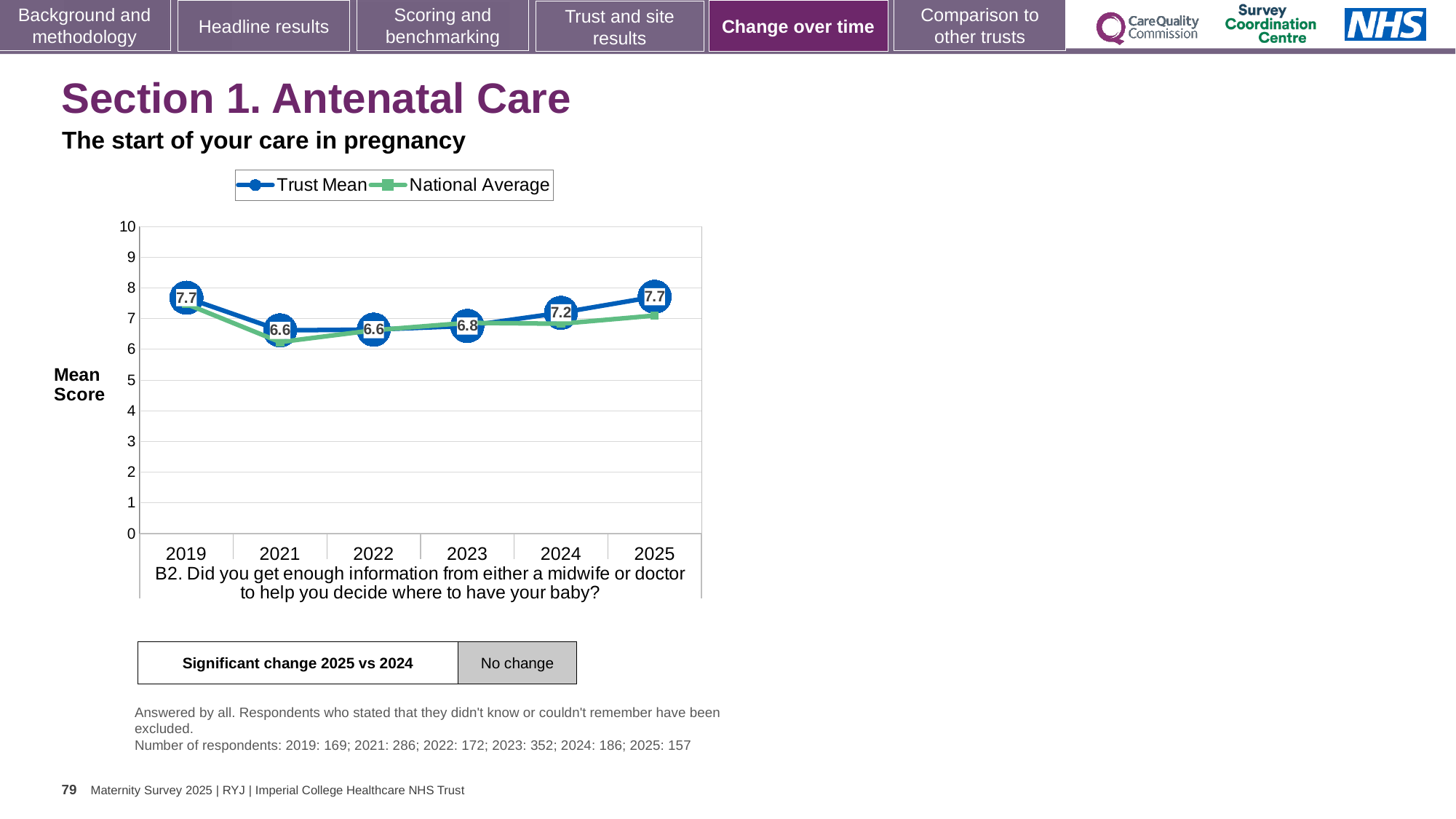
How many years are plotted on the x axis? 6 What is the Trust Mean score for 2024? 7.2 What kind of chart is shown on the slide? Line chart What is the difference between the Trust Mean scores for 2025 and 2024? 0.5 What is the Trust Mean score for 2023? 6.8 Is the National Average value for 2019 greater or less than 7? greater How many series does the legend list? 2 What is the Trust Mean score for 2019? 7.7 Which year has the larger Trust Mean score, 2023 or 2024? 2024 What is the Trust Mean score for 2025? 7.7 Does the Trust Mean rise or fall from 2021 to 2025? Rise Is the National Average value for 2021 greater or less than 7? less